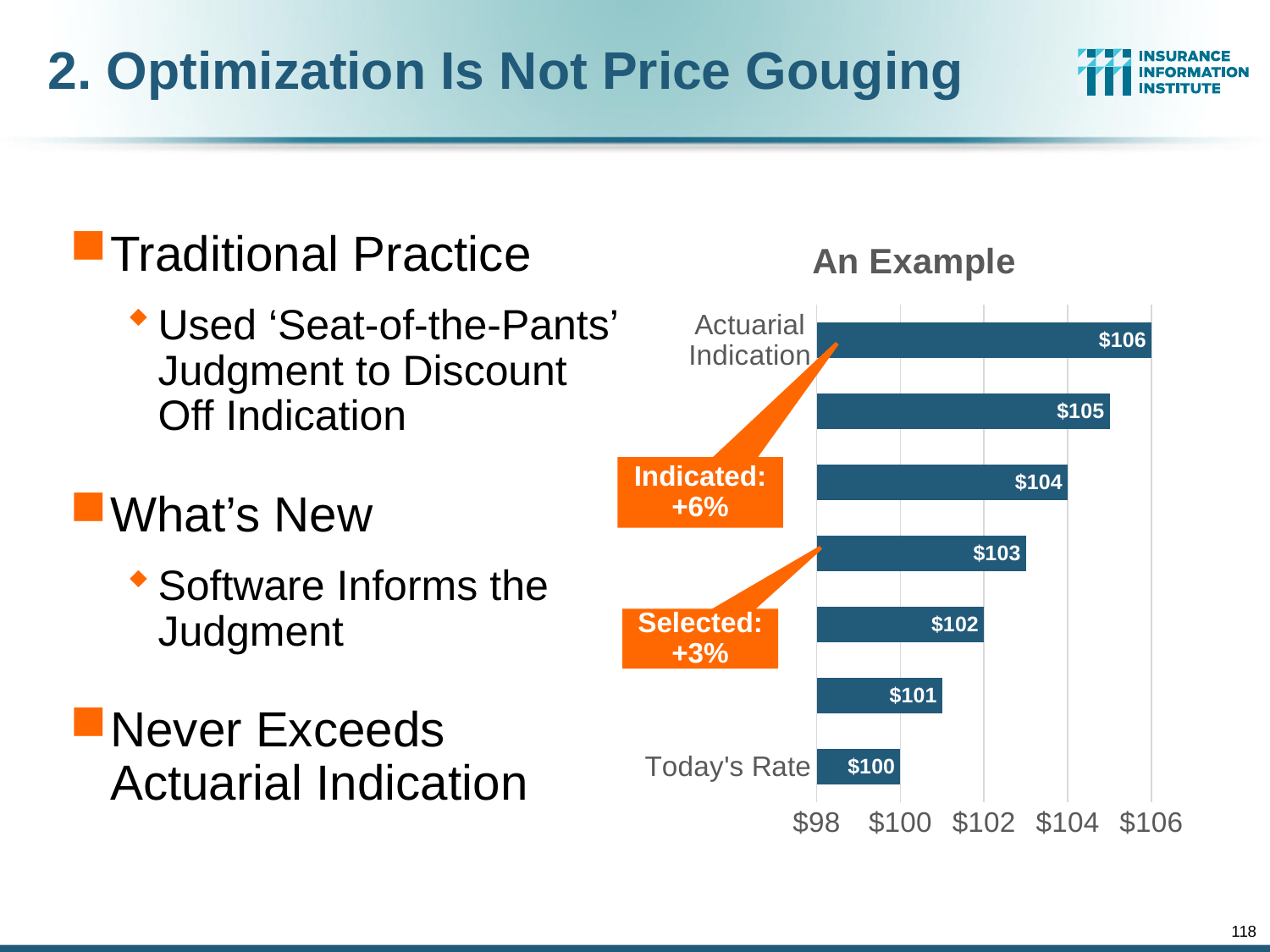
What is the title of the chart on the slide? An Example What is the value for Actuarial Indication in the An Example chart? $106 What kind of chart is shown on the slide? Bar chart Which category has the highest value in the An Example chart? Actuarial Indication Is the value for Today's Rate greater or less than $102 in the An Example chart? less How many bars are plotted in the An Example chart? 7 What is the difference between the Actuarial Indication value and the Today's Rate value in the An Example chart? $6 Which category has the lowest value in the An Example chart? Today's Rate Which is larger in the An Example chart, Actuarial Indication or Today's Rate? Actuarial Indication What is the value for Today's Rate in the An Example chart? $100 Is the value for Actuarial Indication greater or less than $104 in the An Example chart? greater What percentage is shown in the orange callout labelled 'Selected' on the chart? +3%